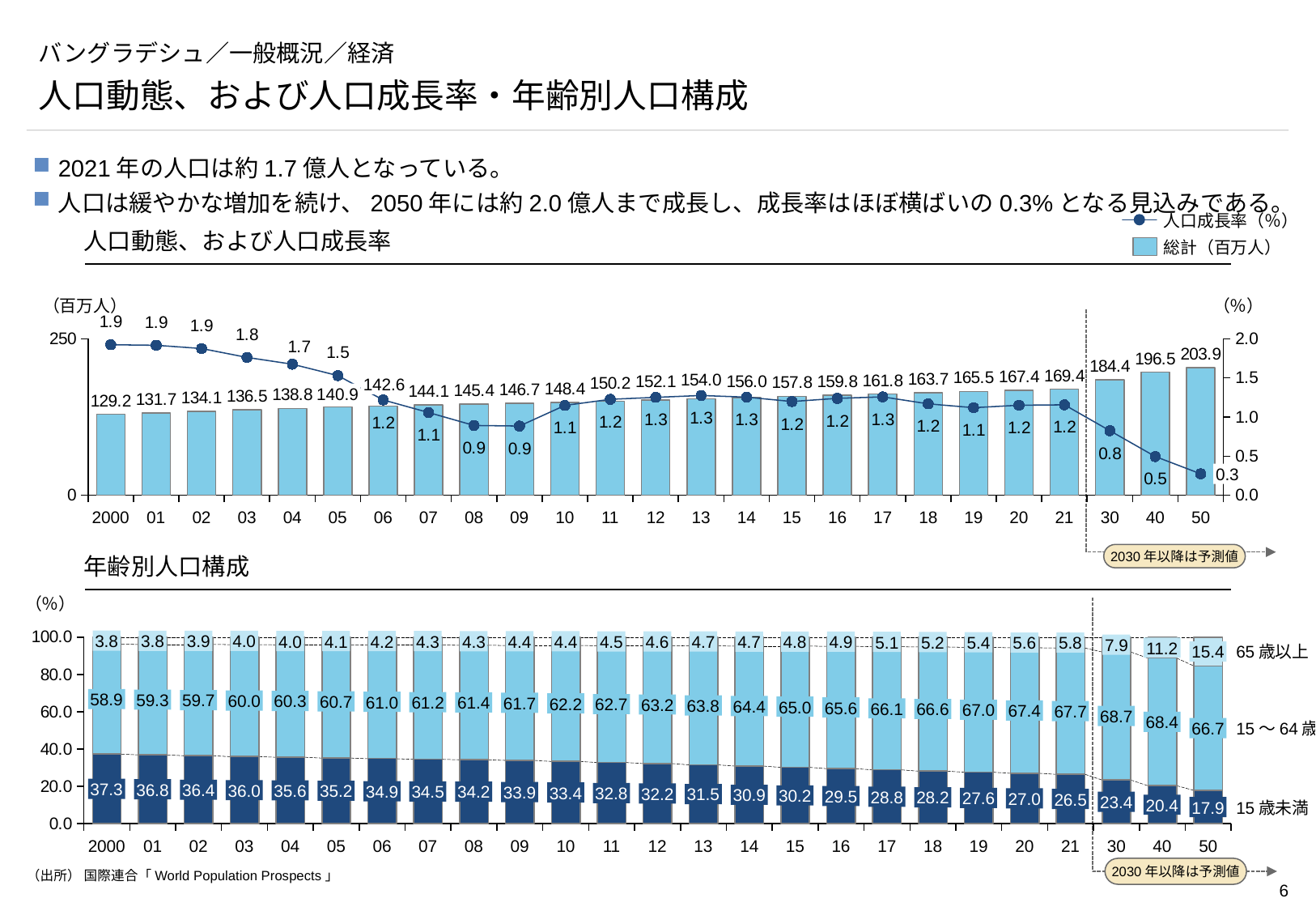
In the top chart (人口動態、および人口成長率), which year has the highest total population? 2050 How many series does the legend of the top chart (人口動態、および人口成長率) list? 2 In the top chart (人口動態、および人口成長率), by how much does the total population in 2050 exceed that in 2000? 74.7 How many years (bars) are shown on the x axis of the bottom chart (年齢別人口構成)? 25 What kind of chart is the bottom chart (年齢別人口構成)? stacked bar chart In the top chart (人口動態、および人口成長率), does the total population rise or fall from 2000 to 2050? rise In the top chart (人口動態、および人口成長率), what is the population growth rate (%) shown for 2050? 0.3 In the top chart (人口動態、および人口成長率), what is the total population (百万人) shown for 2021? 169.4 In the bottom chart (年齢別人口構成), what is the total of the stacked bar for 2021? 100.0 In the bottom chart (年齢別人口構成), what is the share of 65歳以上 in 2050? 15.4 In the top chart (人口動態、および人口成長率), which year has the lowest population growth rate? 2050 In the top chart (人口動態、および人口成長率), which year has the higher growth rate, 2000 or 2021? 2000